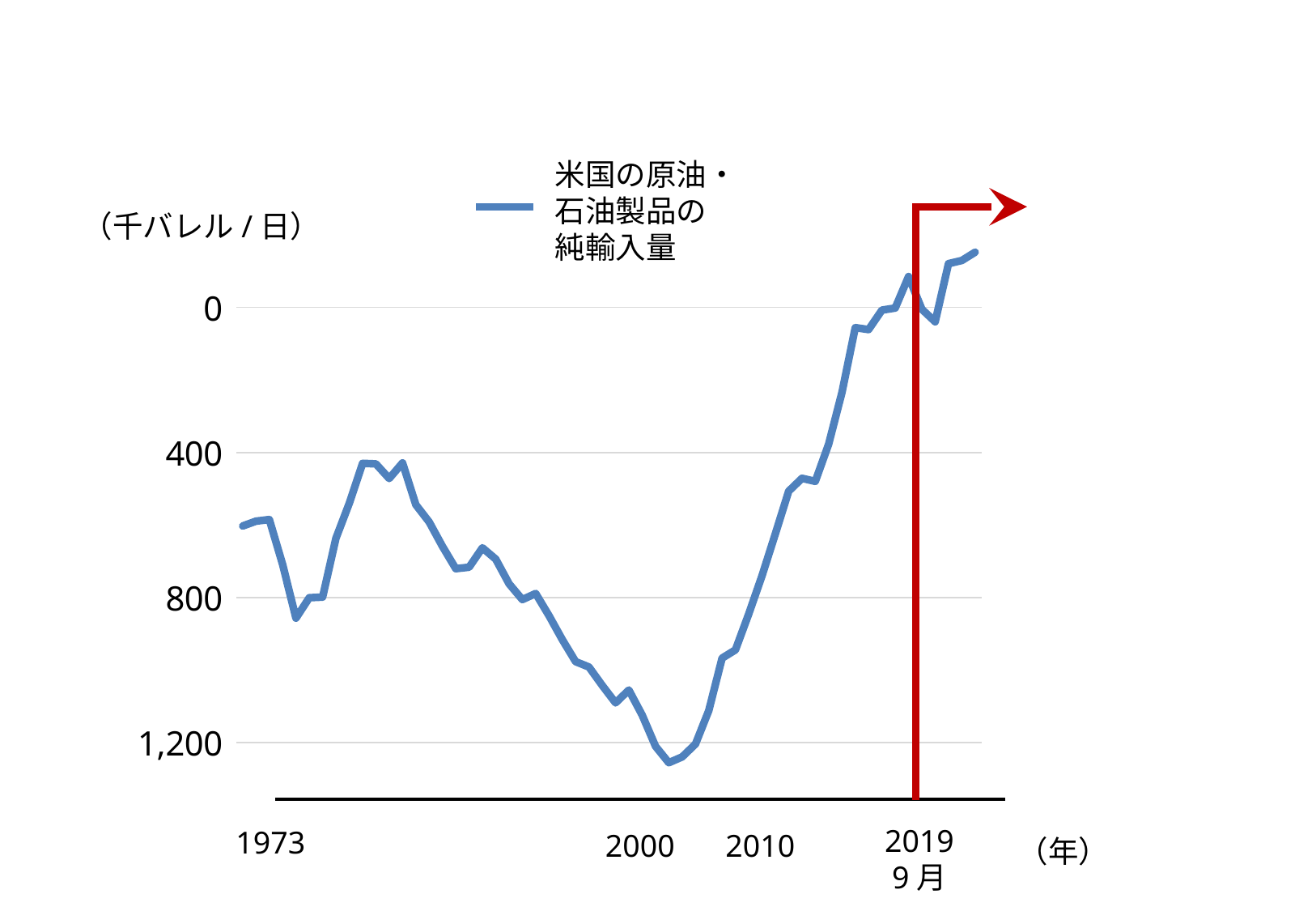
How many series does the legend list? 1 What is the name of the series shown in the legend? 米国の原油・石油製品の純輸入量 What kind of chart is shown on the slide? line chart How many year labels are shown on the horizontal axis? 4 Which is larger, the value for 2000 or the value for 2010? 2000 What unit is shown for the vertical axis? 千バレル / 日 Is the value for 2010 greater or less than 400? greater Is the value for 1973 greater or less than 400? greater What is the highest tick value shown on the vertical axis? 1,200 Is the value for 1973 greater or less than 800? less Between 2010 and 2019, do the net import values rise or fall? fall